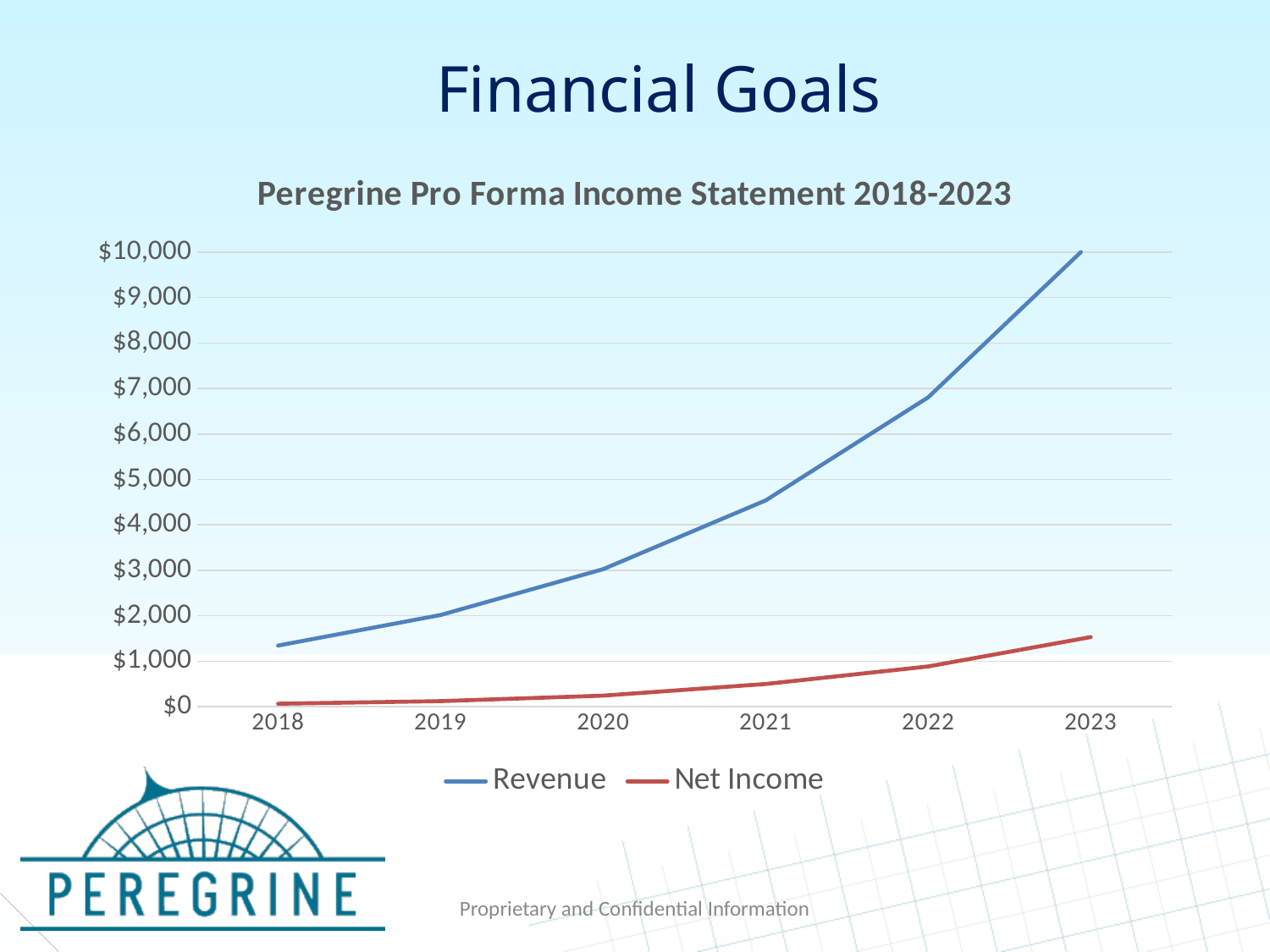
What kind of chart is shown on the slide? line chart How many years are plotted along the x axis? 6 What is the title of the chart? Peregrine Pro Forma Income Statement 2018-2023 In which year is Revenue highest? 2023 Is the Revenue value for 2022 greater or less than $7,000? less Is the Revenue value for 2021 greater or less than $4,000? greater How many series does the legend list? 2 Which series is drawn in red? Net Income Does Revenue rise or fall from 2018 to 2023? rise Is the Net Income value for 2023 greater or less than $1,000? greater In which year is Net Income lowest? 2018 In 2020, which is larger, Revenue or Net Income? Revenue